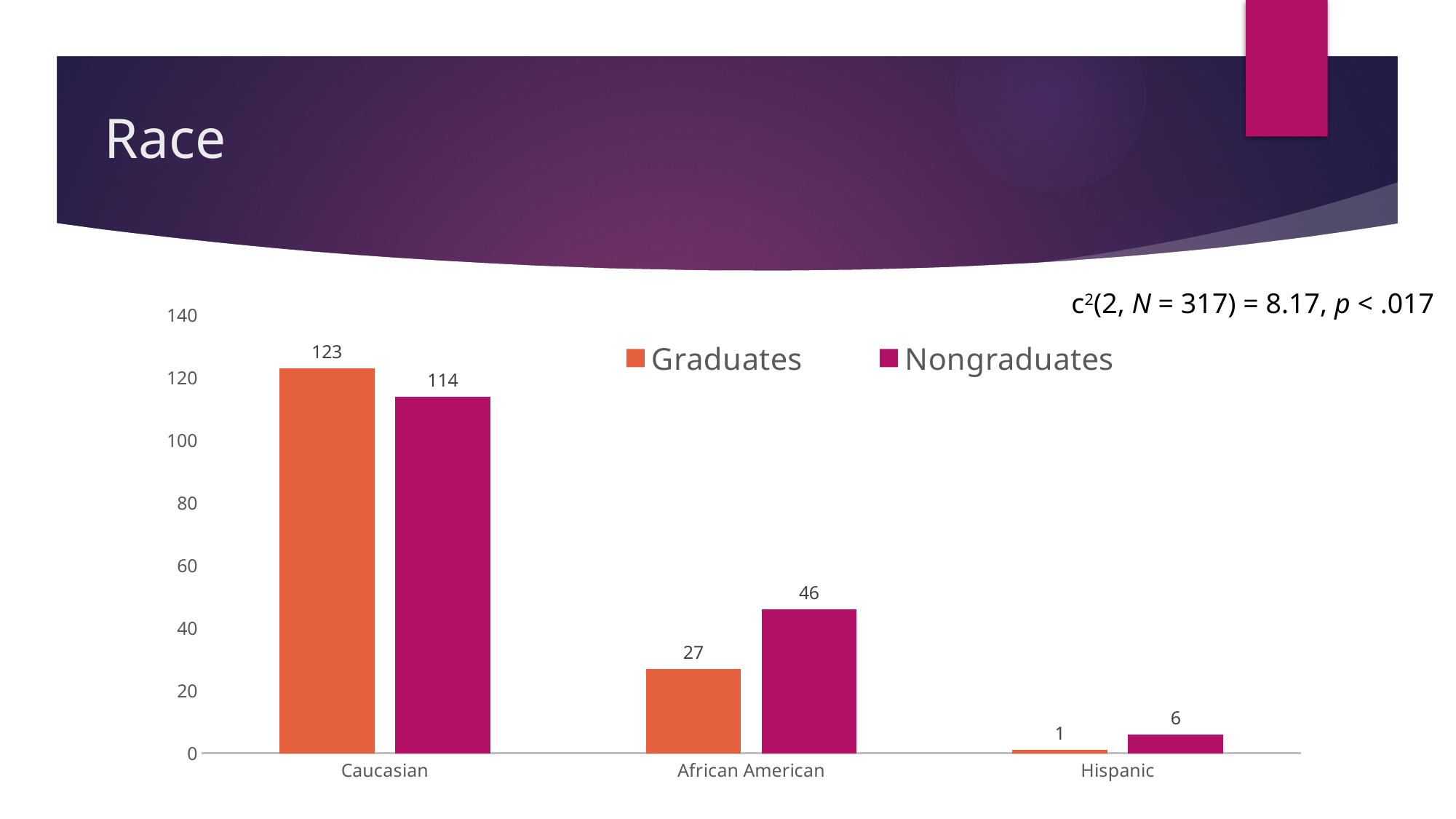
How many series does the legend list? 2 Which category has the lowest Graduates value? Hispanic What is the value for Graduates in the Caucasian category? 123 What is the difference between Graduates and Nongraduates in the Caucasian category? 9 In the African American category, which is larger: Graduates or Nongraduates? Nongraduates What kind of chart is shown on the slide? bar chart What is the value for Graduates in the Hispanic category? 1 Is the Nongraduates value for Caucasian greater or less than 100? greater What is the value for Nongraduates in the African American category? 46 How many categories are shown on the x axis? 3 What is the difference between Nongraduates and Graduates in the African American category? 19 Which category has the highest Nongraduates value? Caucasian